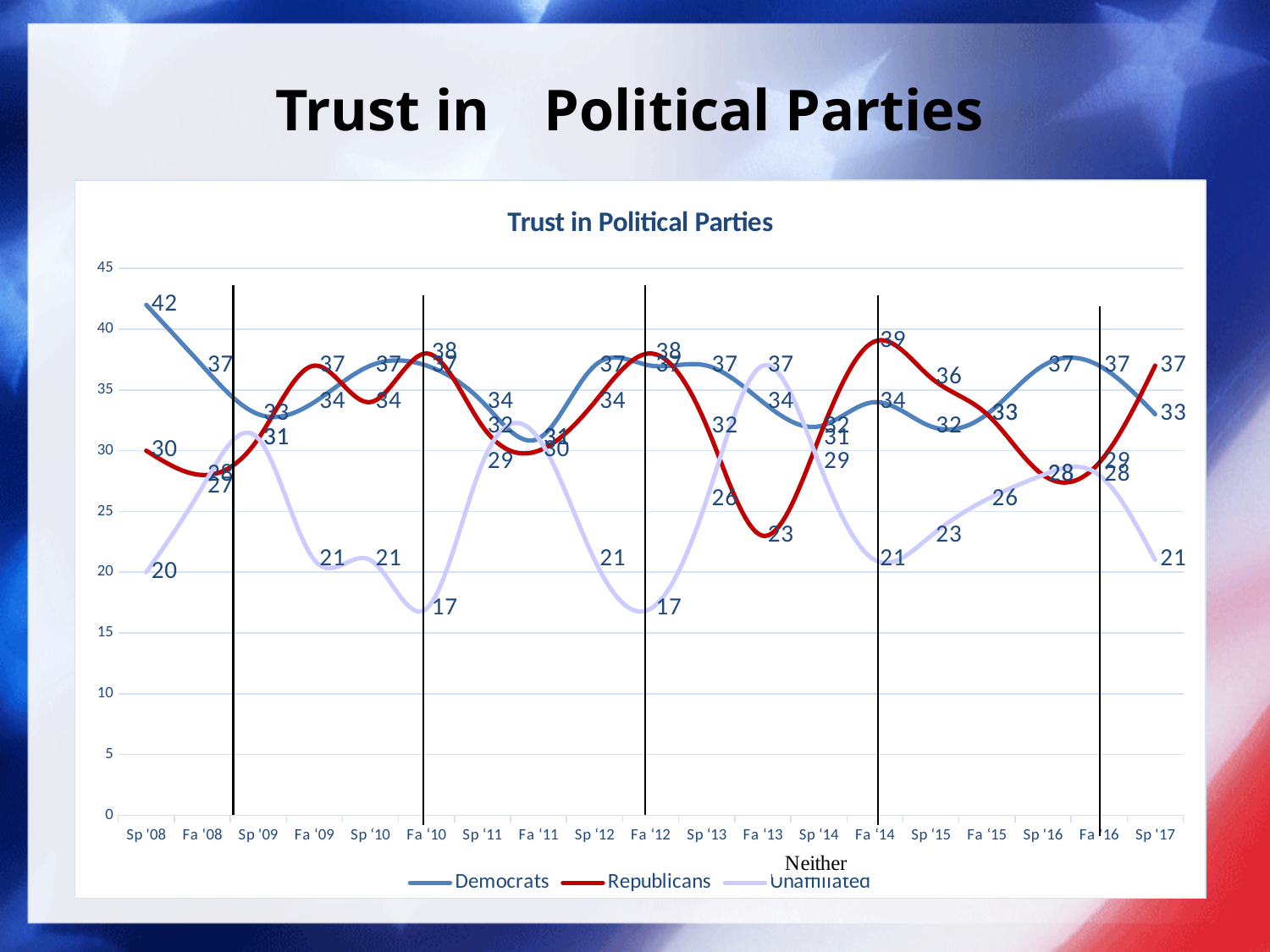
What is the title of the chart? Trust in Political Parties What is the lowest value reached by the Neither/Unaffiliated series? 17 What is the value for Republicans in Fa '13? 23 What is the value for Republicans in Fa '14? 39 What type of chart is shown on the slide? line chart What is the value for Democrats in Sp '08? 42 At which time point is the Democrats series highest? Sp '08 What is the value for Neither/Unaffiliated in Fa '13? 37 How many series does the legend list? 3 In Sp '17, which series has the larger value, Democrats or Republicans? Republicans In Sp '08, how much higher is the Democrats value than the Republicans value? 12 How many time points are shown along the x axis? 19